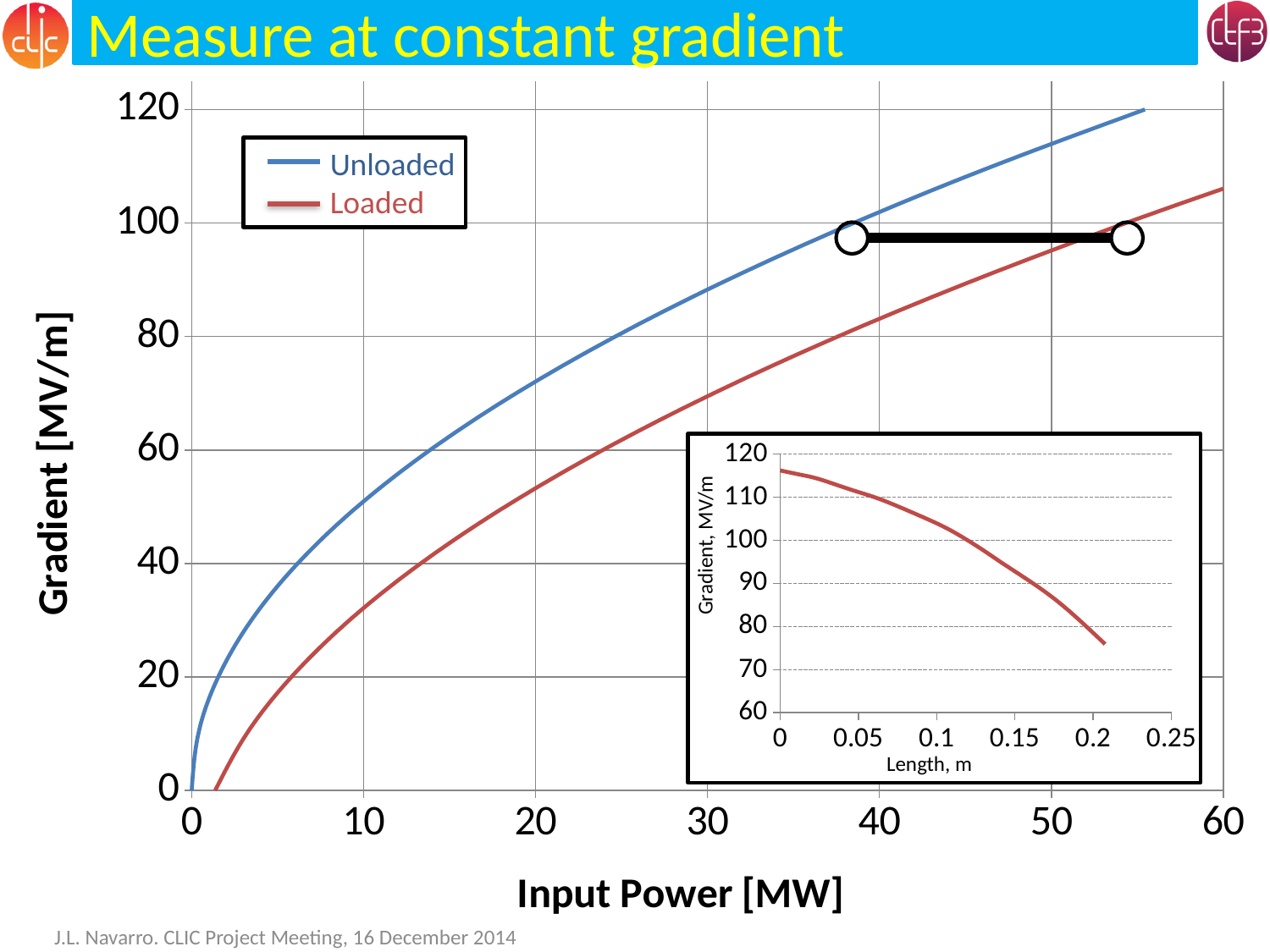
In the main chart, is the Unloaded gradient at 50 MW input power greater or less than 100 MV/m? greater In the inset chart of Gradient versus Length, is the gradient at a length of 0.1 m greater or less than 100 MV/m? greater What is the x-axis label of the main chart? Input Power [MW] In the main chart, does the gradient rise or fall as input power increases? rise What kind of chart is the main chart of Gradient versus Input Power? line chart In the inset chart of Gradient versus Length, does the gradient rise or fall as length increases? fall In the main chart, is the Loaded gradient at 50 MW input power greater or less than 100 MV/m? less How many series does the legend of the main chart list? 2 In the main chart, which series is higher at an input power of 30 MW, Unloaded or Loaded? Unloaded What are the two series named in the legend of the main chart? Unloaded and Loaded